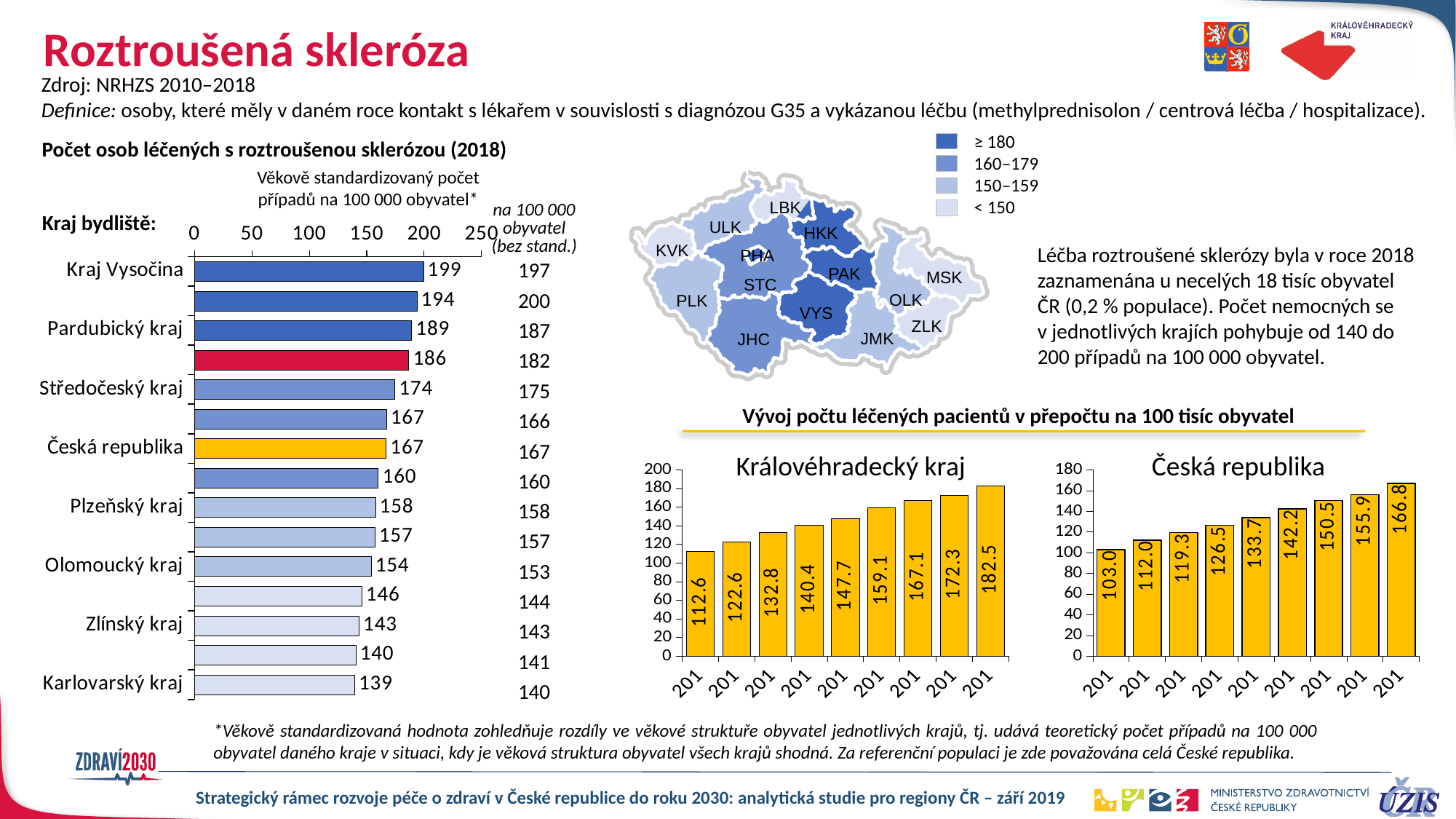
In the chart 'Královéhradecký kraj', how many bars are plotted? 9 In the chart 'Počet osob léčených s roztroušenou sklerózou (2018)', which region has the highest age-standardised value? Kraj Vysočina In the chart 'Česká republika', what is the value of the first (leftmost) bar? 103.0 In the chart 'Počet osob léčených s roztroušenou sklerózou (2018)', what kind of chart is used? bar chart In the chart 'Počet osob léčených s roztroušenou sklerózou (2018)', which has the larger age-standardised value, Středočeský kraj or Olomoucký kraj? Středočeský kraj In the chart 'Počet osob léčených s roztroušenou sklerózou (2018)', what is the age-standardised value for Kraj Vysočina? 199 In the chart 'Počet osob léčených s roztroušenou sklerózou (2018)', what is the difference between the age-standardised values for Pardubický kraj and Plzeňský kraj? 31 In the chart 'Počet osob léčených s roztroušenou sklerózou (2018)', what is the age-standardised value for Karlovarský kraj? 139 In the chart 'Česká republika', do the values rise or fall from left to right? rise In the chart 'Počet osob léčených s roztroušenou sklerózou (2018)', which region has the lowest age-standardised value? Karlovarský kraj In the chart 'Česká republika', what is the difference between the last bar and the first bar? 63.8 In the chart 'Královéhradecký kraj', what is the value of the last (rightmost) bar? 182.5